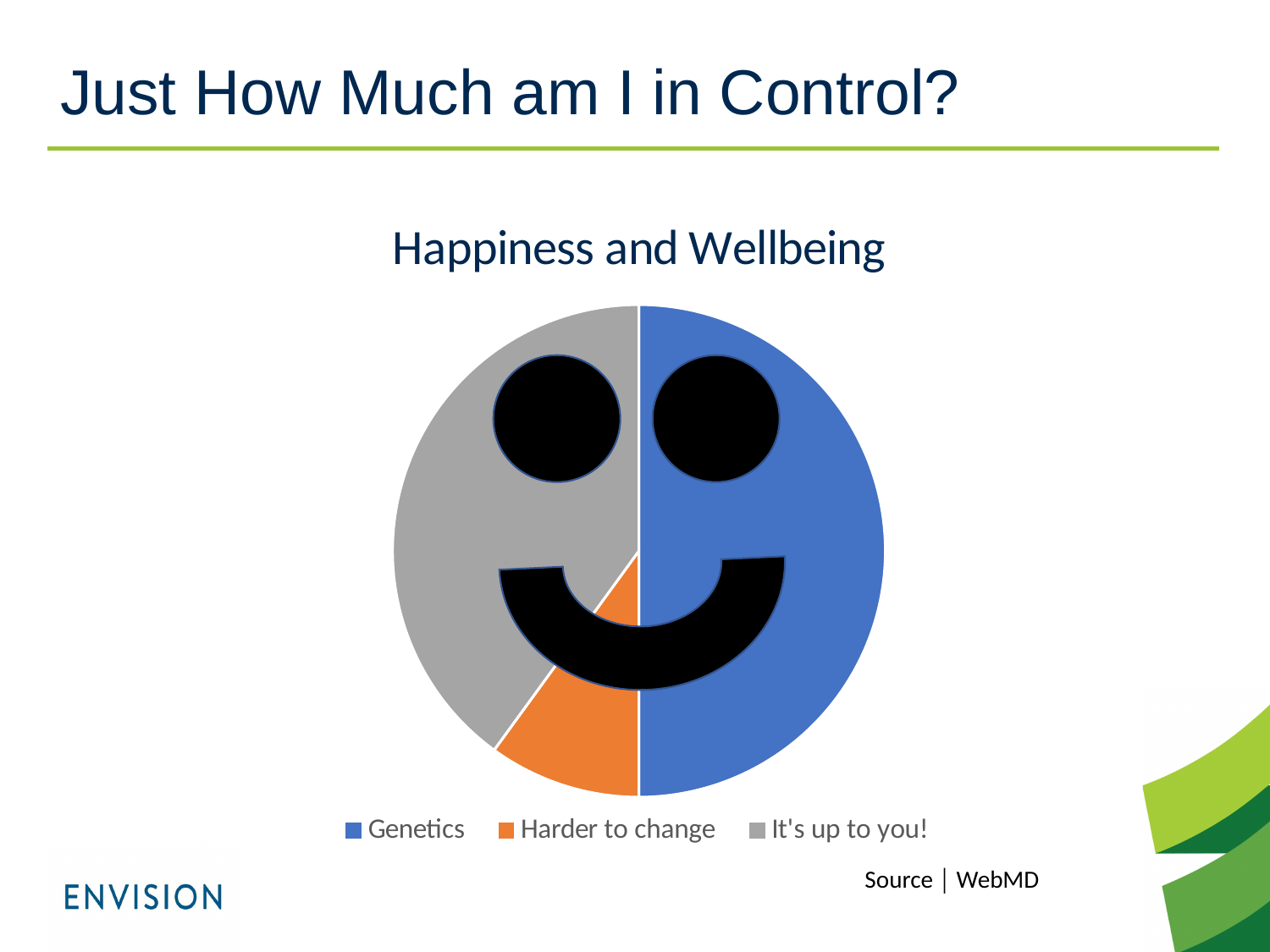
Which slice is larger, Genetics or Harder to change? Genetics How many slices does the pie chart have? 3 What kind of chart is shown on the slide? pie chart How many entries does the legend list? 3 Which slice is larger, It's up to you! or Harder to change? It's up to you! Which slice of the pie chart is the largest? Genetics Which slice is larger, Genetics or It's up to you!? Genetics Which colour represents the Harder to change slice in the pie chart? orange What is the title of the chart? Happiness and Wellbeing Which slice of the pie chart is the smallest? Harder to change